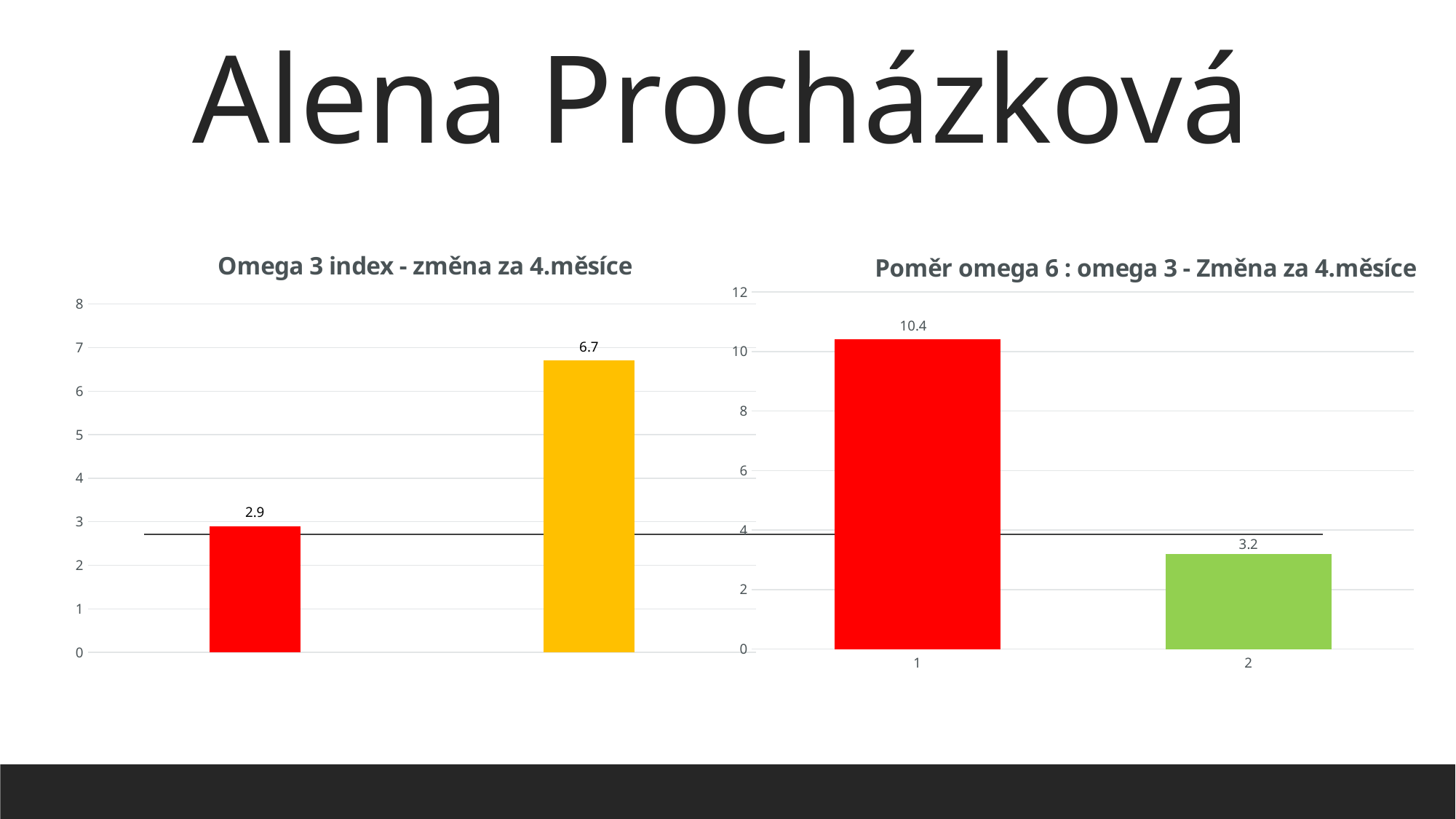
In the chart titled "Omega 3 index - změna za 4.měsíce", do the values rise or fall from left to right? rise In the chart titled "Poměr omega 6 : omega 3 - Změna za 4.měsíce", what is the value for category 2? 3.2 In the chart titled "Omega 3 index - změna za 4.měsíce", what is the value of the orange bar on the right? 6.7 In the chart titled "Poměr omega 6 : omega 3 - Změna za 4.měsíce", what is the difference between the values for category 1 and category 2? 7.2 In the chart titled "Poměr omega 6 : omega 3 - Změna za 4.měsíce", is the value for category 1 greater or less than 8? greater In the chart titled "Poměr omega 6 : omega 3 - Změna za 4.měsíce", what is the value for category 1? 10.4 In the chart titled "Poměr omega 6 : omega 3 - Změna za 4.měsíce", which category has the highest value? 1 In the chart titled "Omega 3 index - změna za 4.měsíce", what is the value of the red bar on the left? 2.9 What kind of chart is the chart on the right of the slide? bar chart In the chart titled "Poměr omega 6 : omega 3 - Změna za 4.měsíce", what colour is the bar for category 2? green In the chart titled "Omega 3 index - změna za 4.měsíce", what is the difference between the two bar values? 3.8 In the chart titled "Omega 3 index - změna za 4.měsíce", how many bars are plotted? 2